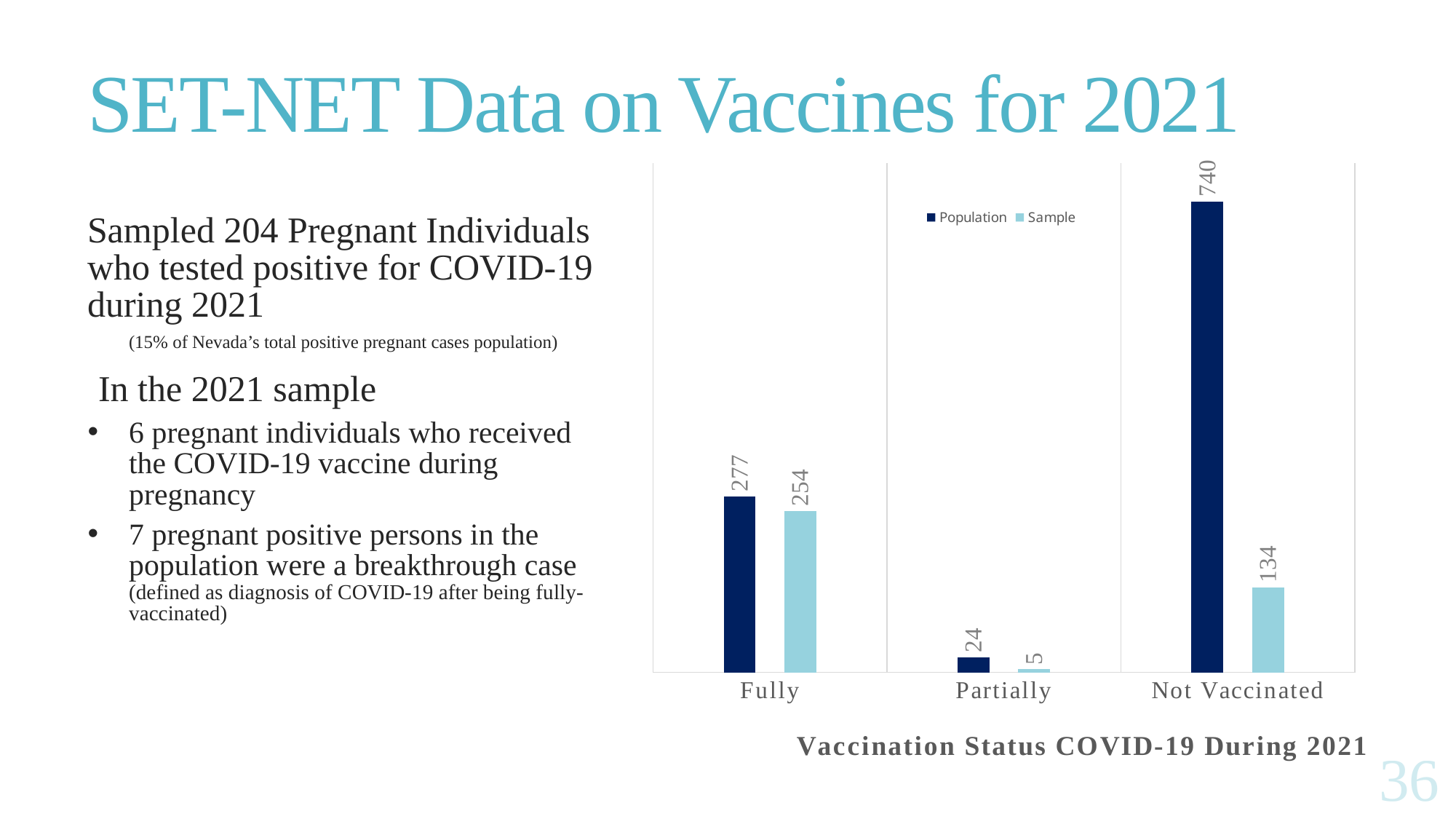
What is the Sample value for Not Vaccinated? 134 What is the Population value for Fully vaccinated? 277 What is the difference between the Population and Sample values for Not Vaccinated? 606 Which is larger, the Population value for Fully or the Sample value for Fully? Population What is the Population value for Partially vaccinated? 24 How many series does the legend list? 2 How many vaccination status categories are shown on the x axis? 3 What kind of chart is shown on the slide? Bar chart What is the title shown below the chart's x axis? Vaccination Status COVID-19 During 2021 Which vaccination status has the highest Population value? Not Vaccinated Which vaccination status has the lowest Sample value? Partially What is the Sample value for Partially vaccinated? 5